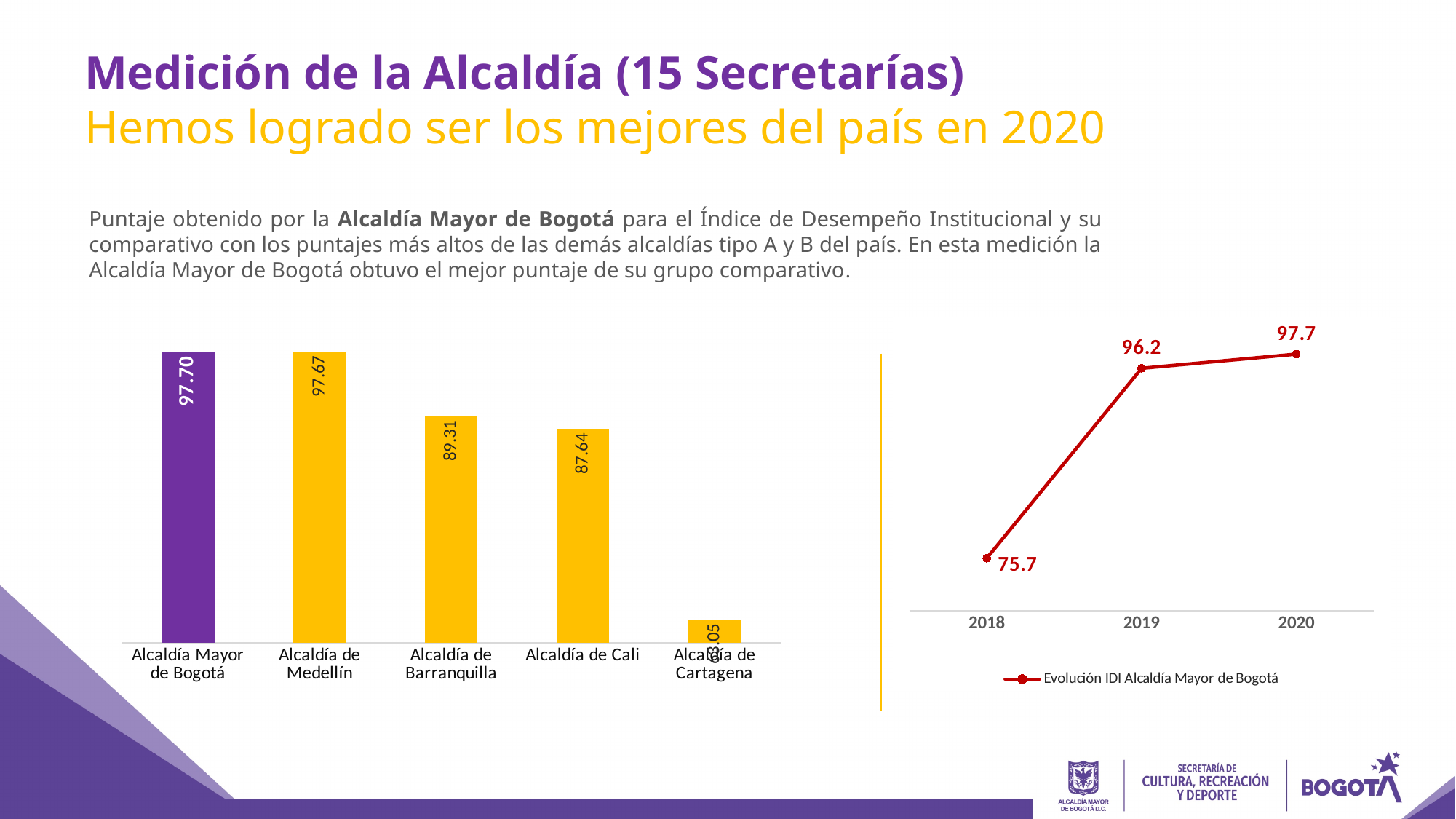
In the line chart on the right, what is the value for 2019? 96.2 In the line chart on the right, do the values rise or fall from 2018 to 2020? rise In the line chart on the right, what is the difference between the values for 2019 and 2018? 20.5 In the bar chart on the left, what is the difference between the values for Alcaldía de Barranquilla and Alcaldía de Cali? 1.67 In the bar chart on the left, what is the value for Alcaldía de Medellín? 97.67 In the bar chart on the left, which category has the lowest value? Alcaldía de Cartagena In the bar chart on the left, what is the value for Alcaldía de Cali? 87.64 In the bar chart on the left, which is larger, the value for Alcaldía de Barranquilla or Alcaldía de Cali? Alcaldía de Barranquilla In the bar chart on the left, which bar is coloured purple rather than yellow? Alcaldía Mayor de Bogotá How many bars are in the bar chart on the left? 5 In the line chart on the right, what is the value for 2018? 75.7 In the bar chart on the left, what is the value for Alcaldía de Barranquilla? 89.31